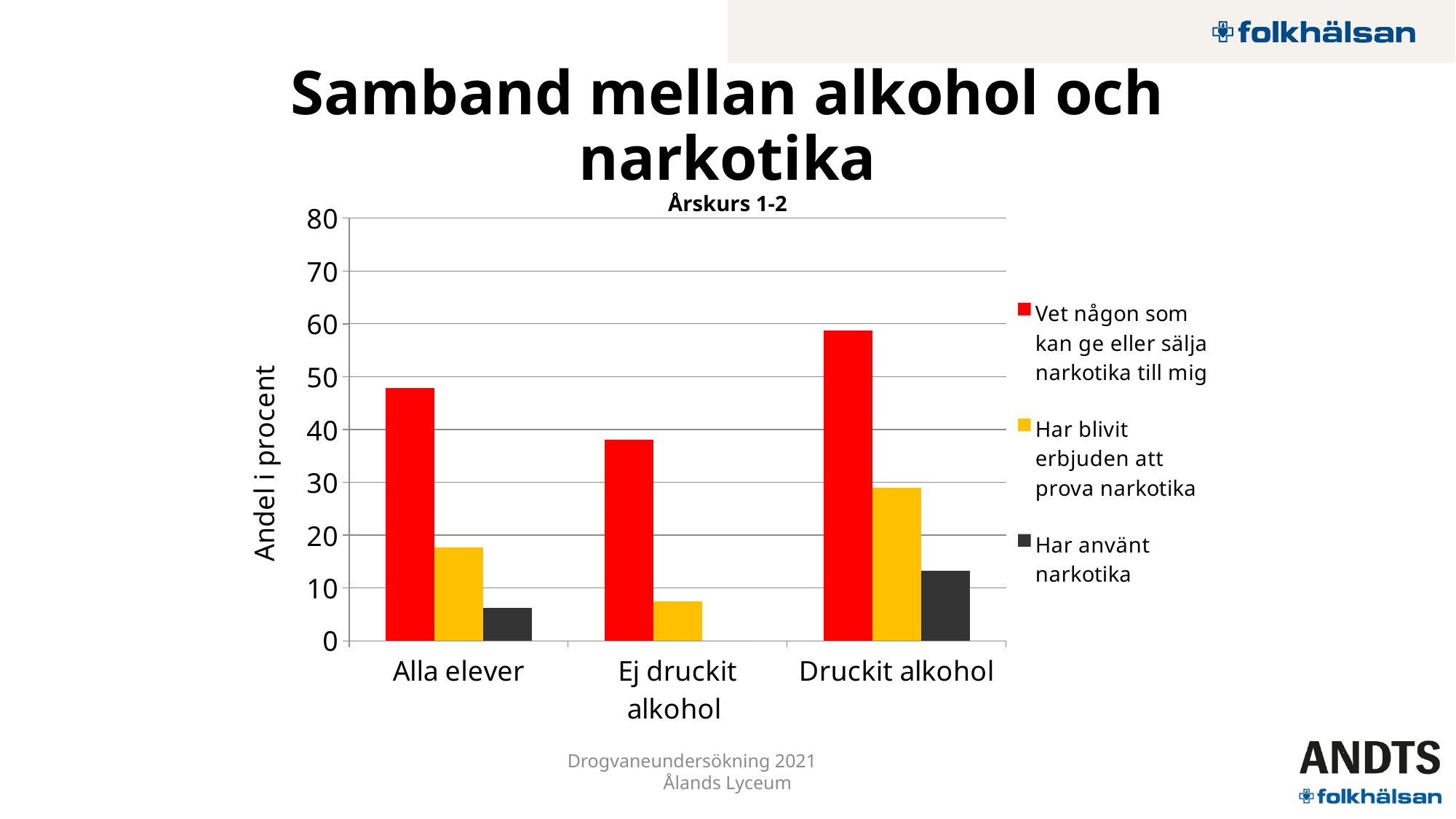
What is the title of the chart? Årskurs 1-2 Is the value for 'Vet någon som kan ge eller sälja narkotika till mig' in the 'Druckit alkohol' category greater or less than 50? greater Is the value for 'Vet någon som kan ge eller sälja narkotika till mig' in the 'Ej druckit alkohol' category greater or less than 30? greater How many series does the legend list? 3 What kind of chart is shown on the slide? bar chart What is the label on the vertical axis of the chart? Andel i procent For 'Har använt narkotika', which category has the larger value: 'Alla elever' or 'Druckit alkohol'? Druckit alkohol How many categories are shown on the x axis? 3 Which category has the highest value for 'Vet någon som kan ge eller sälja narkotika till mig'? Druckit alkohol Which category has the lowest value for 'Har blivit erbjuden att prova narkotika'? Ej druckit alkohol Is the value for 'Vet någon som kan ge eller sälja narkotika till mig' in the 'Alla elever' category greater or less than 40? greater